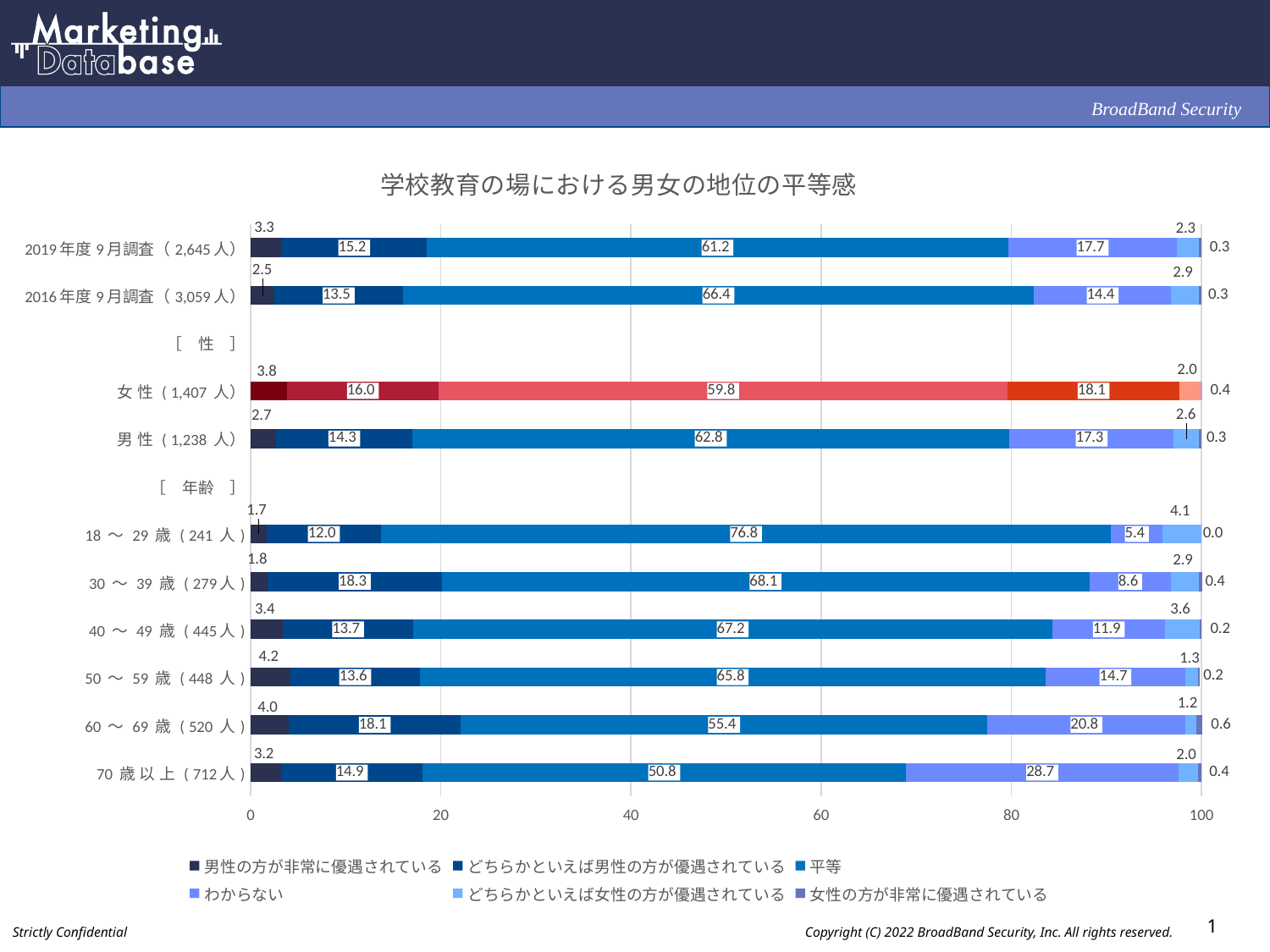
What is the value of 平等 for 2019年度9月調査 (2,645人)? 61.2 What is the title of the chart? 学校教育の場における男女の地位の平等感 What is the value of わからない for 70歳以上 (712人)? 28.7 Which category has the lowest value for 平等? 70歳以上 (712人) Which has a larger value for わからない: 女性 (1,407人) or 男性 (1,238人)? 女性 (1,407人) Which category has the highest value for 平等? 18〜29歳 (241人) What is the difference between the 平等 values for 2016年度9月調査 and 2019年度9月調査? 5.2 How many series does the legend list? 6 What kind of chart is shown on the slide? Stacked bar chart What is the value of 男性の方が非常に優遇されている for 50〜59歳 (448人)? 4.2 What is the value of どちらかといえば男性の方が優遇されている for 女性 (1,407人)? 16.0 Is the value of 平等 for 60〜69歳 (520人) greater or less than 60? less